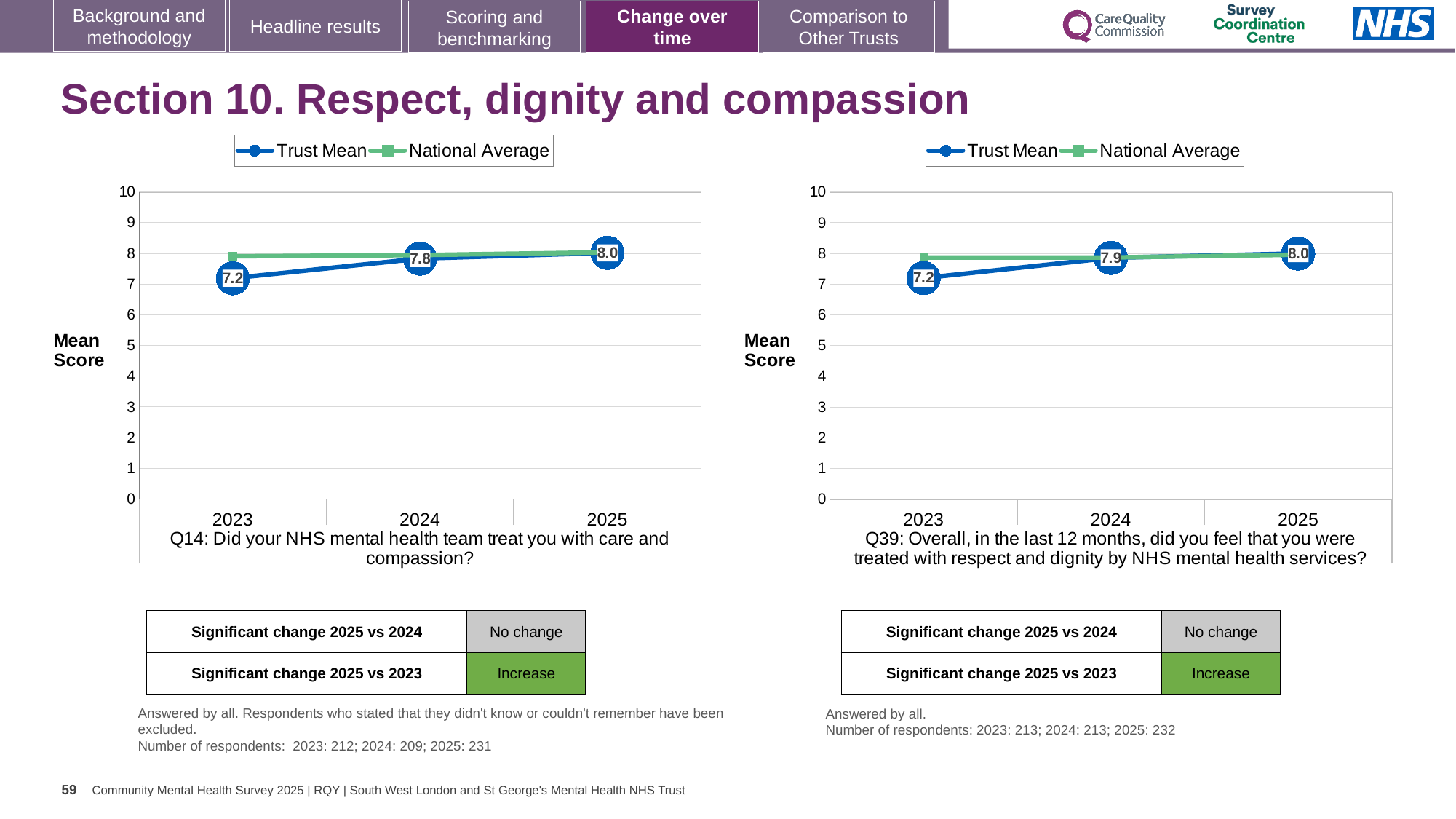
In the Q14 chart on the left, what is the Trust Mean for 2023? 7.2 In the Q39 chart on the right, what is the Trust Mean for 2024? 7.9 In the Q14 chart on the left, which year has the lowest Trust Mean? 2023 What kind of chart is the Q39 chart on the right? line chart How many series does the legend of the Q14 chart on the left list? 2 In the Q14 chart on the left, is the Trust Mean for 2024 greater or less than the Trust Mean for 2023? greater In the Q39 chart on the right, what is the difference between the Trust Mean for 2024 and 2023? 0.7 In the Q14 chart on the left, what is the Trust Mean for 2025? 8.0 In the Q39 chart on the right, what is the Trust Mean for 2023? 7.2 In the Q39 chart on the right, does the Trust Mean rise or fall from 2023 to 2025? rise In the Q14 chart on the left, what is the difference between the Trust Mean for 2025 and 2023? 0.8 In the Q39 chart on the right, which year has the highest Trust Mean? 2025